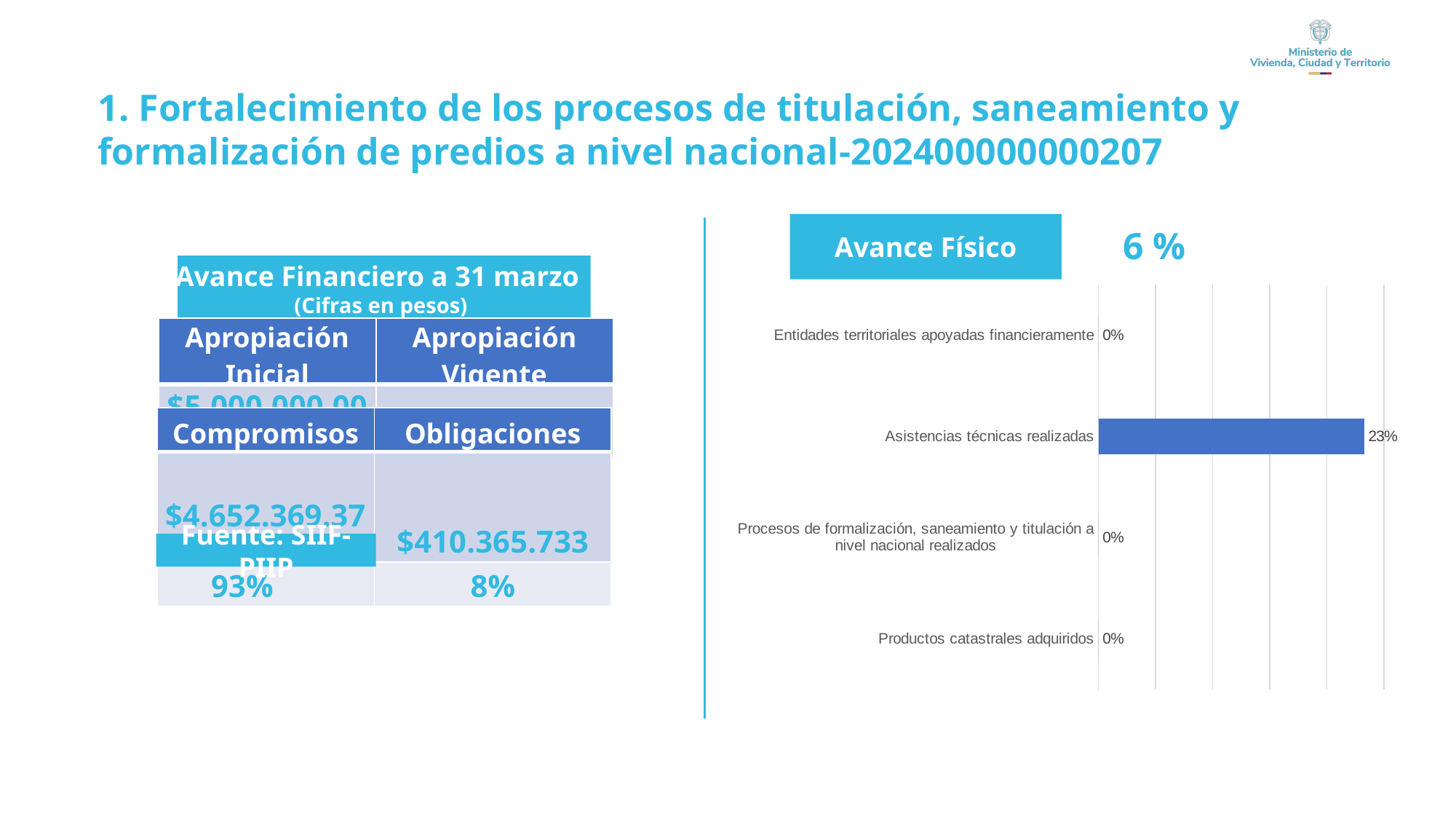
What is the value for "Asistencias técnicas realizadas" in the bar chart? 23% How many categories does the bar chart show? 4 Which category has the highest value in the bar chart? Asistencias técnicas realizadas What is the difference between the value for "Asistencias técnicas realizadas" and the value for "Productos catastrales adquiridos" in the bar chart? 23% What kind of chart is shown on the right side of the slide under "Avance Físico"? bar chart What is the value for "Entidades territoriales apoyadas financieramente" in the bar chart? 0% What is the title shown above the bar chart? Avance Físico What is the value for "Procesos de formalización, saneamiento y titulación a nivel nacional realizados" in the bar chart? 0% What overall percentage is shown next to the "Avance Físico" title? 6 % How many categories in the bar chart have a value of 0%? 3 Which is larger in the bar chart: the value for "Asistencias técnicas realizadas" or the value for "Entidades territoriales apoyadas financieramente"? Asistencias técnicas realizadas What is the value for "Productos catastrales adquiridos" in the bar chart? 0%